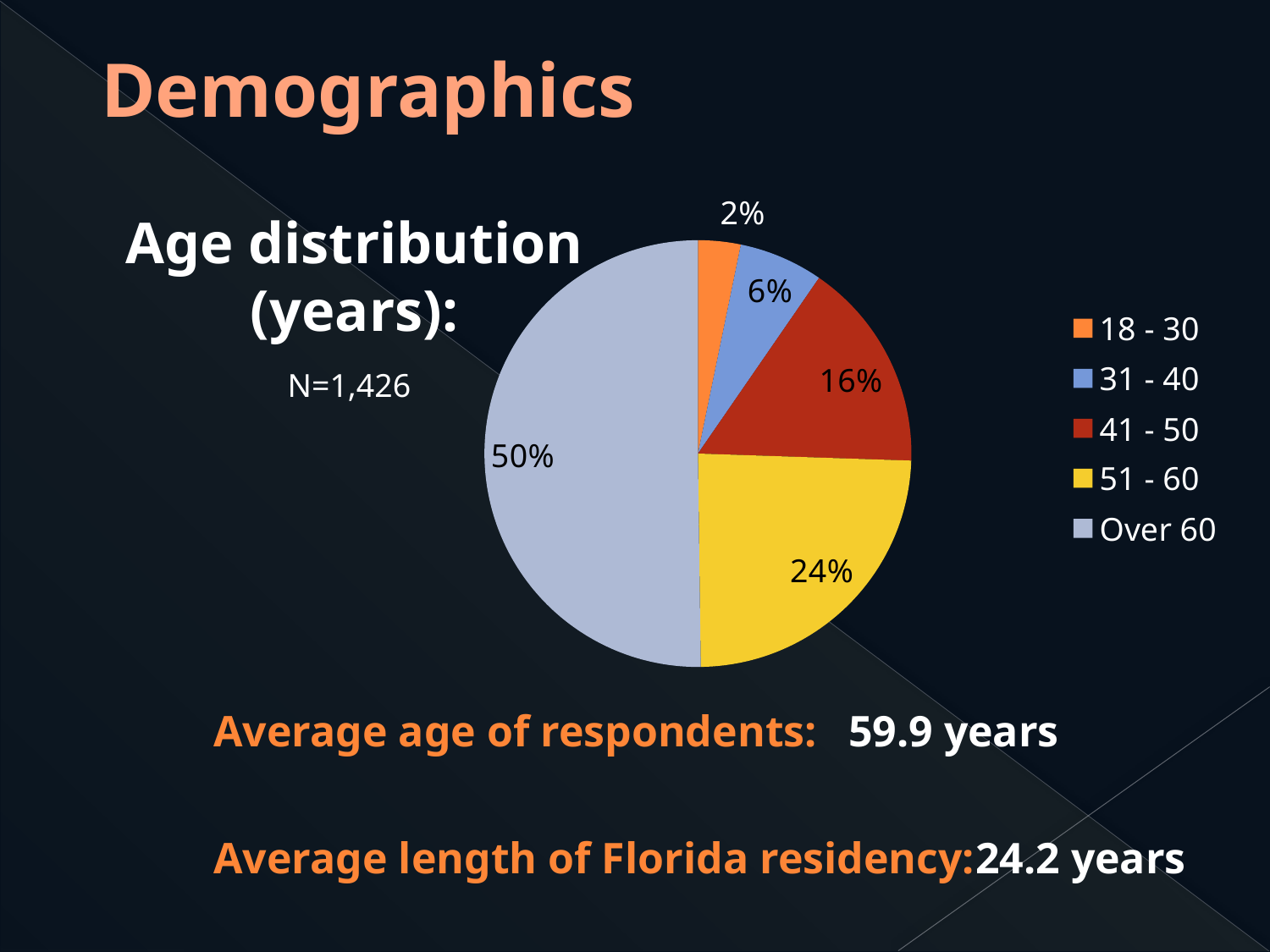
How many age groups does the legend list? 5 Which age group has the smallest share of respondents? 18 - 30 What share of respondents are aged 41 - 50? 16% Which age group has the largest share of respondents? Over 60 Which group has a larger share, 41 - 50 or 31 - 40? 41 - 50 What kind of chart is shown on the slide? pie chart What share of respondents are aged 31 - 40? 6% What is the sample size (N) shown for the age distribution chart? N=1,426 What share of respondents are aged 51 - 60? 24% What is the difference in percentage points between the Over 60 and 51 - 60 groups? 26